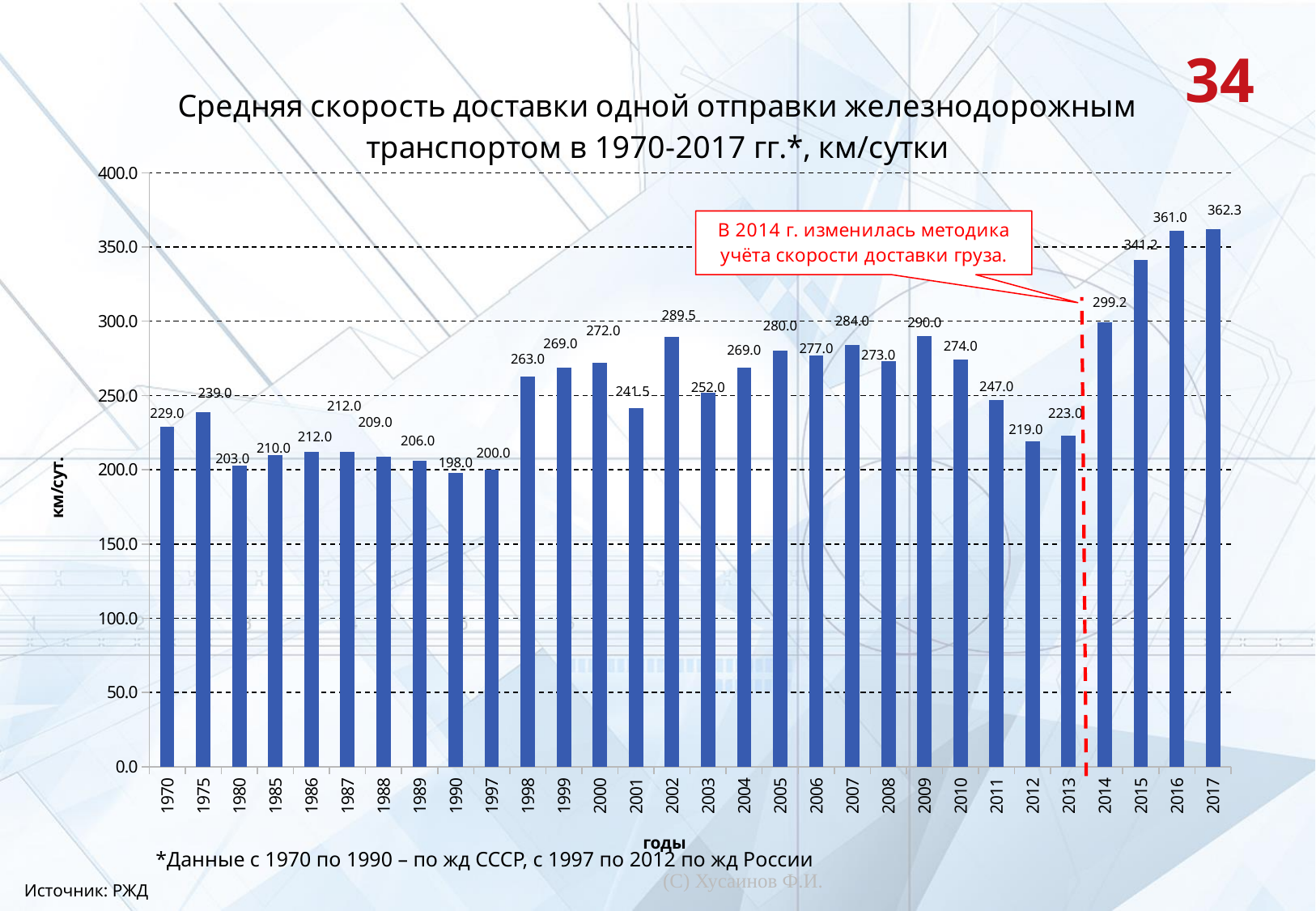
What is the label of the y axis? км/сут. Which is larger, the value for 2009 or the value for 2005? 2009 What is the value for 2002? 289.5 Which year has the lowest value? 1990 Which year has the highest value? 2017 Is the value for 2013 greater or less than 250.0? less What is the value for 1990? 198.0 What is the value for 2014? 299.2 What is the difference between the values for 2015 and 2014? 42.0 How many years are shown on the x axis? 30 What kind of chart is this? bar chart What is the difference between the values for 2017 and 2016? 1.3